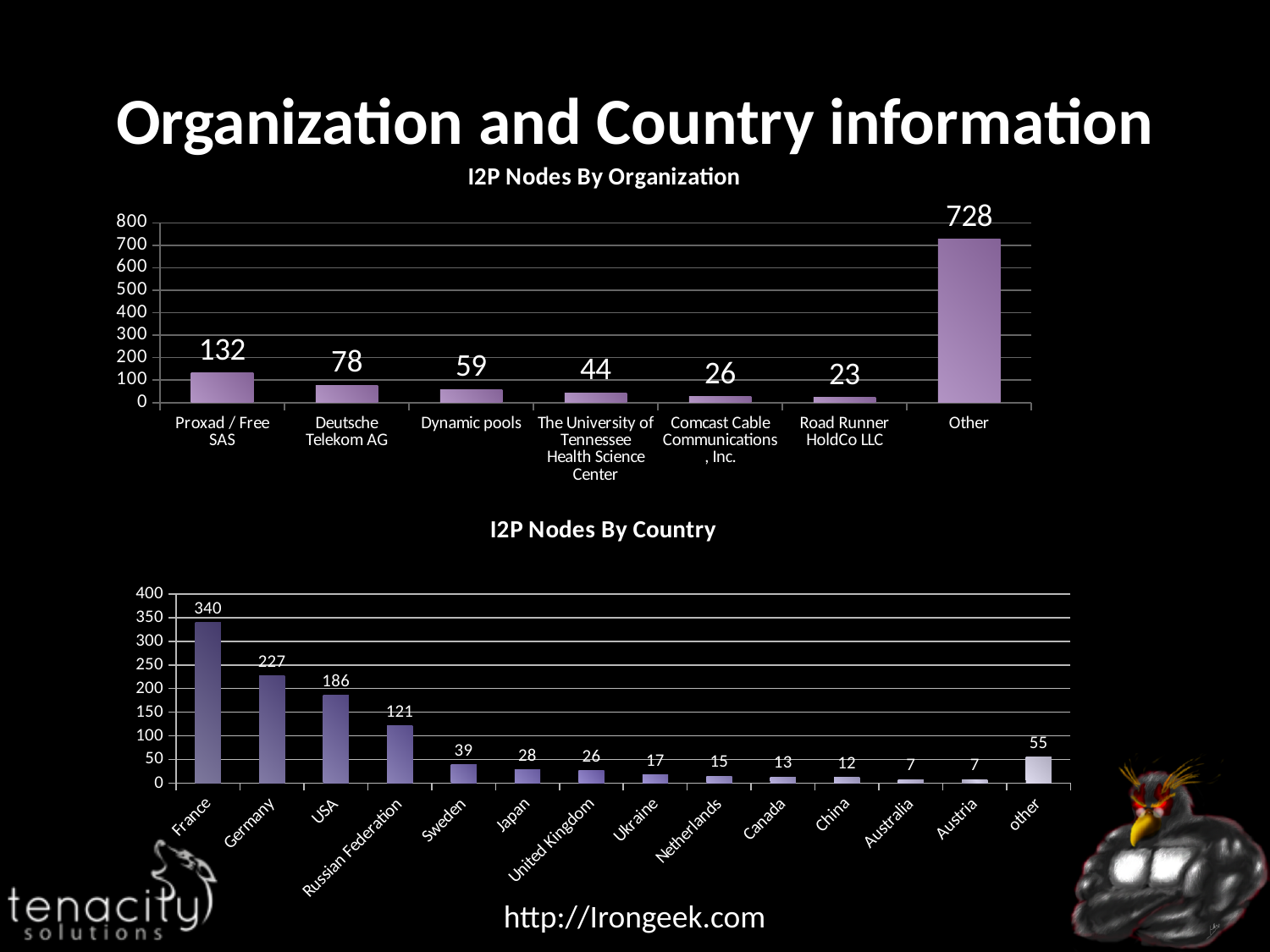
In the 'I2P Nodes By Country' chart, how many categories are shown on the x axis? 14 In the 'I2P Nodes By Organization' chart, which category has the highest value? Other In the 'I2P Nodes By Country' chart, which country has the highest value? France In the 'I2P Nodes By Organization' chart, how many categories are shown? 7 In the 'I2P Nodes By Country' chart, which is larger, Sweden or Japan? Sweden In the 'I2P Nodes By Country' chart, what is the value for Russian Federation? 121 What kind of chart is 'I2P Nodes By Country'? Bar chart In the 'I2P Nodes By Organization' chart, what is the difference between Proxad / Free SAS and Dynamic pools? 73 In the 'I2P Nodes By Organization' chart, what is the value for Deutsche Telekom AG? 78 In the 'I2P Nodes By Organization' chart, which category has the lowest value? Road Runner HoldCo LLC In the 'I2P Nodes By Country' chart, what is the difference between France and Germany? 113 In the 'I2P Nodes By Country' chart, what is the value for the 'other' category? 55